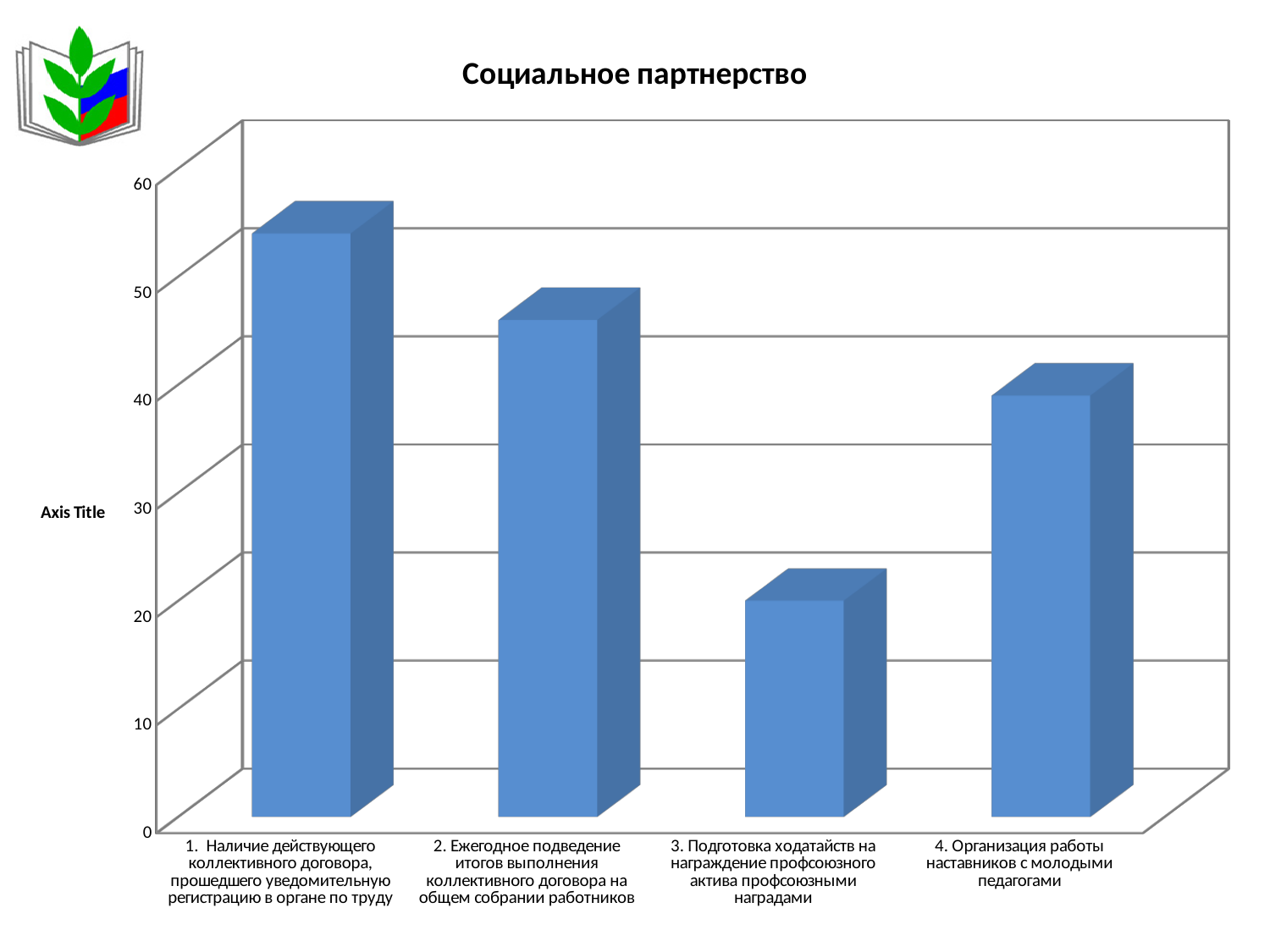
Which category has the highest value? 1. Наличие действующего коллективного договора, прошедшего уведомительную регистрацию в органе по труду Is the value for '3. Подготовка ходатайств на награждение профсоюзного актива...' greater or less than 30? less Is the value for '4. Организация работы наставников с молодыми педагогами' greater or less than 30? greater Is the value for '2. Ежегодное подведение итогов выполнения коллективного договора...' greater or less than 50? less How many categories (bars) are shown in the chart? 4 Which category has the lowest value? 3. Подготовка ходатайств на награждение профсоюзного актива профсоюзными наградами Which is larger: the value for '2. Ежегодное подведение итогов...' or the value for '4. Организация работы наставников...'? 2. Ежегодное подведение итогов выполнения коллективного договора на общем собрании работников What is the title of the chart? Социальное партнерство What label is shown on the vertical axis? Axis Title What type of chart is shown on the slide? Bar chart